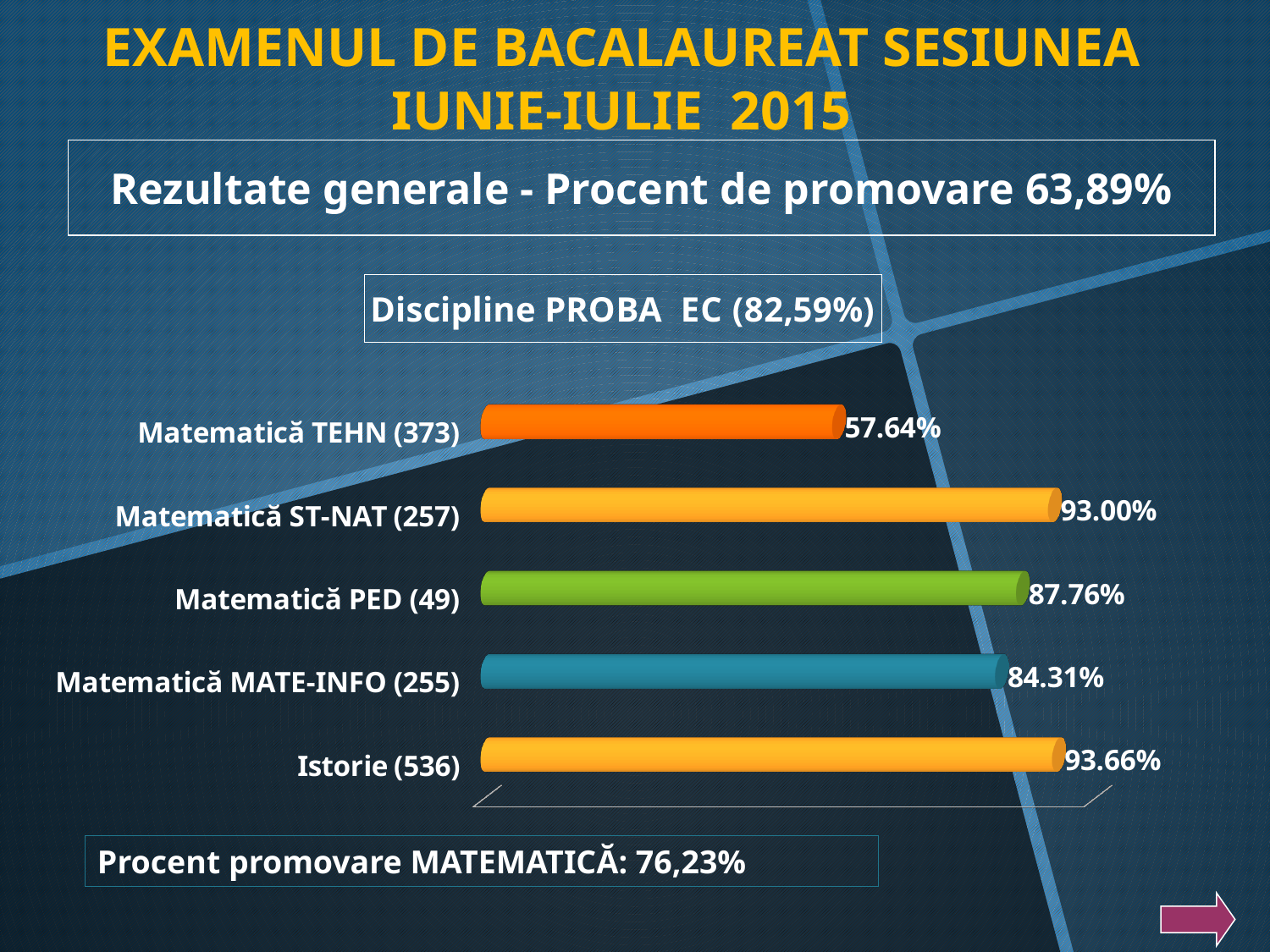
What is the value for Matematică TEHN (373)? 57.64% How many categories are shown in the chart? 5 What is the value for Istorie (536)? 93.66% What is the difference between the values for Matematică ST-NAT (257) and Matematică PED (49)? 5.24% Which is larger, the value for Matematică PED (49) or Matematică MATE-INFO (255)? Matematică PED (49) What is the title of the chart? Discipline PROBA EC (82,59%) What is the value for Matematică PED (49)? 87.76% What is the value for Matematică MATE-INFO (255)? 84.31% Which category has the highest value? Istorie (536) What is the difference between the values for Istorie (536) and Matematică TEHN (373)? 36.02% What kind of chart is shown on the slide? Bar chart Which category has the lowest value? Matematică TEHN (373)